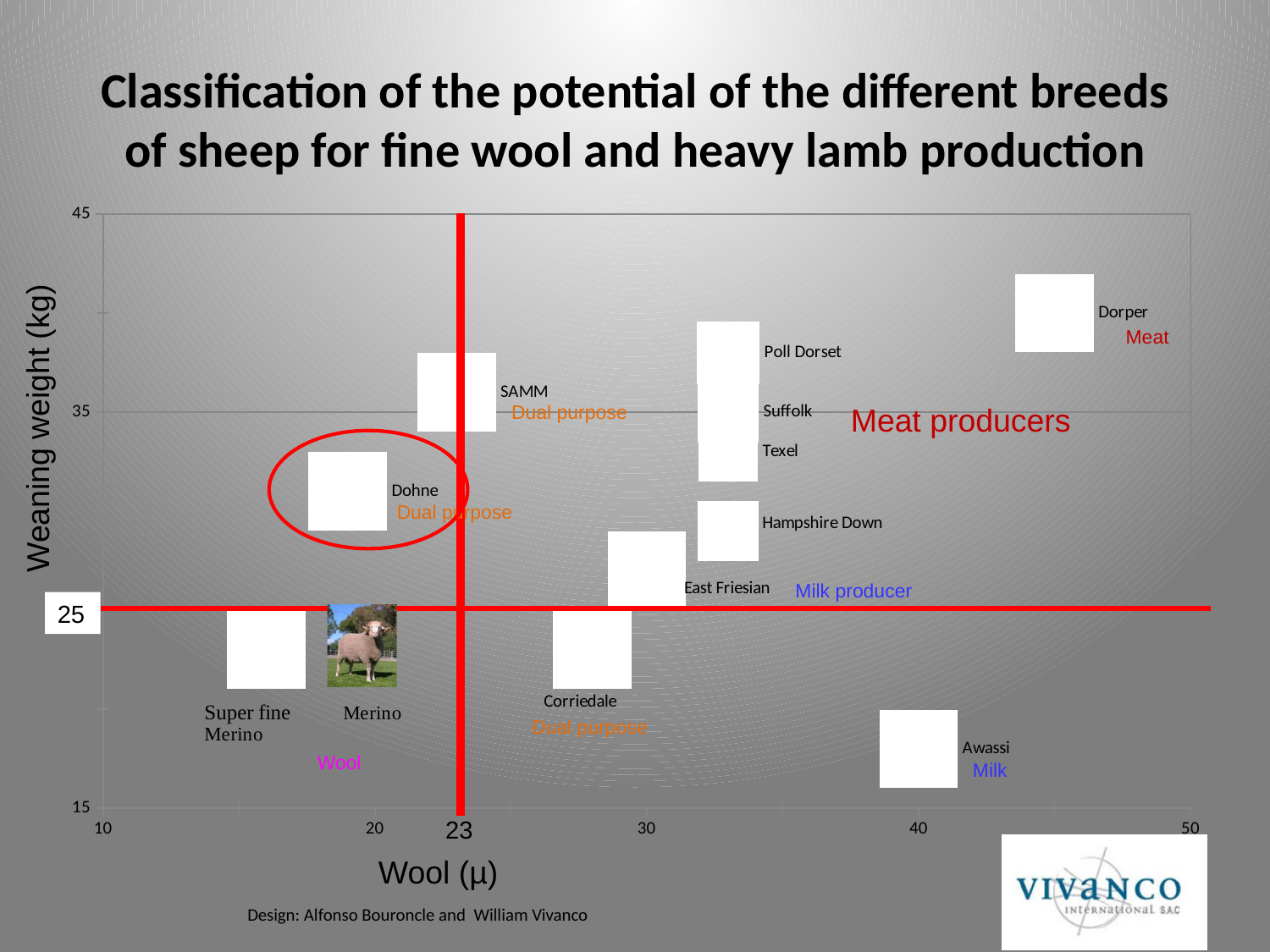
What is the label of the x axis? Wool (µ) Is the weaning weight for Awassi greater or less than 25 kg? less What kind of chart is shown on the slide? Scatter chart Which breed has the lowest weaning weight? Awassi Is the wool value for Dohne greater or less than 23 µ? less Which breed has the highest wool value (µ)? Dorper How many sheep breeds are labelled on the chart? 12 Which has the higher weaning weight, Dorper or Dohne? Dorper Which breed has the lowest wool value (µ)? Super fine Merino What is the title of the chart? Classification of the potential of the different breeds of sheep for fine wool and heavy lamb production Which breed has the highest weaning weight? Dorper Is the weaning weight for Dorper greater or less than 35 kg? greater